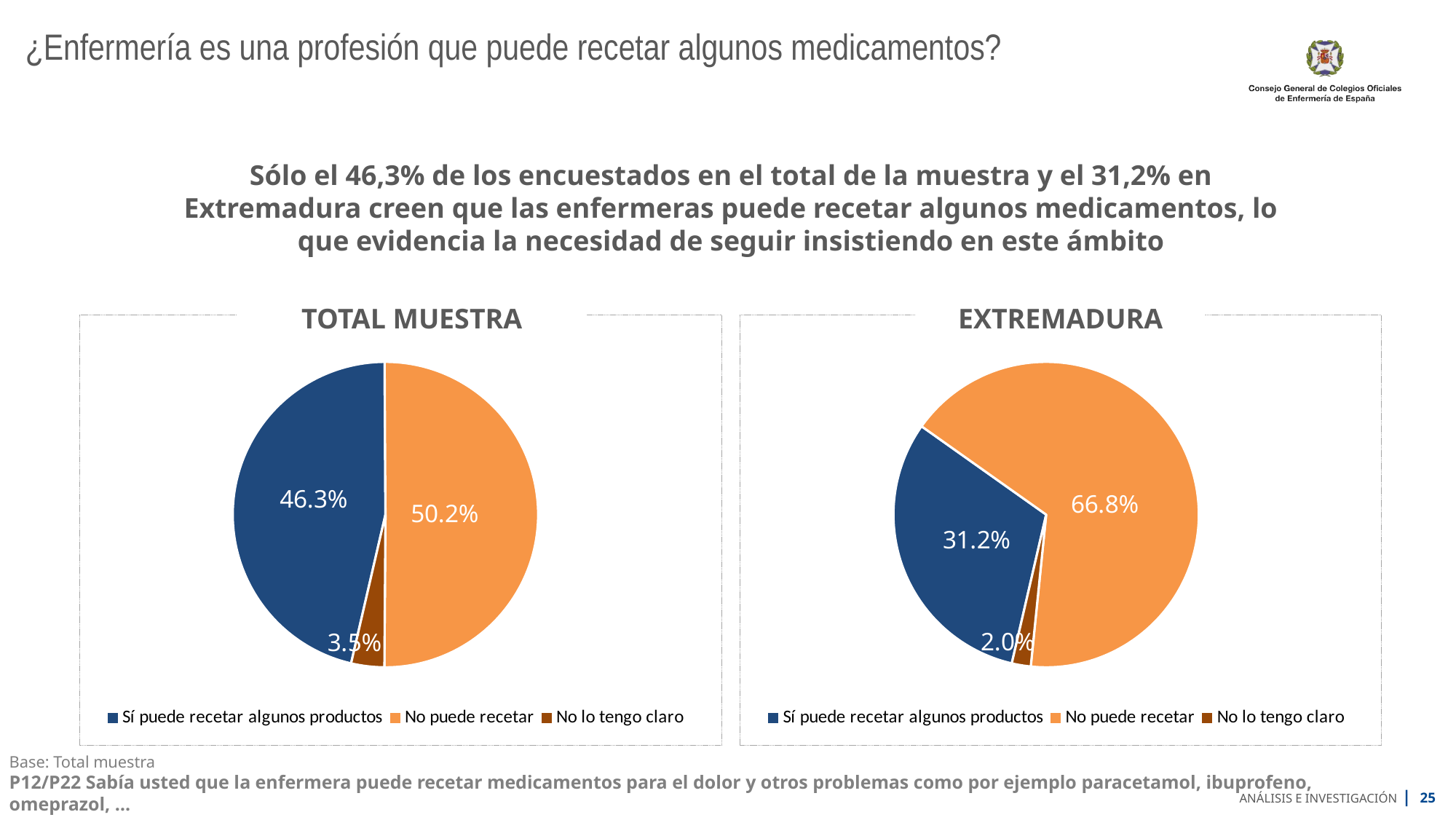
In the TOTAL MUESTRA chart, what percentage corresponds to 'Sí puede recetar algunos productos'? 46.3% What type of chart is used on this slide? Pie chart Which chart shows a larger value for 'Sí puede recetar algunos productos', TOTAL MUESTRA or EXTREMADURA? TOTAL MUESTRA In the EXTREMADURA chart, what is the difference between 'No puede recetar' and 'Sí puede recetar algunos productos'? 35.6% In the TOTAL MUESTRA chart, which category has the smallest slice? No lo tengo claro In the TOTAL MUESTRA chart, what is the difference between 'No puede recetar' and 'Sí puede recetar algunos productos'? 3.9% In the TOTAL MUESTRA chart, what colour is the 'No puede recetar' slice? Orange In the TOTAL MUESTRA chart, what percentage corresponds to 'No puede recetar'? 50.2% How many categories does the legend of the EXTREMADURA chart list? 3 In the EXTREMADURA chart, what percentage corresponds to 'No puede recetar'? 66.8% In the EXTREMADURA chart, which category has the largest slice? No puede recetar In the EXTREMADURA chart, what percentage corresponds to 'No lo tengo claro'? 2.0%